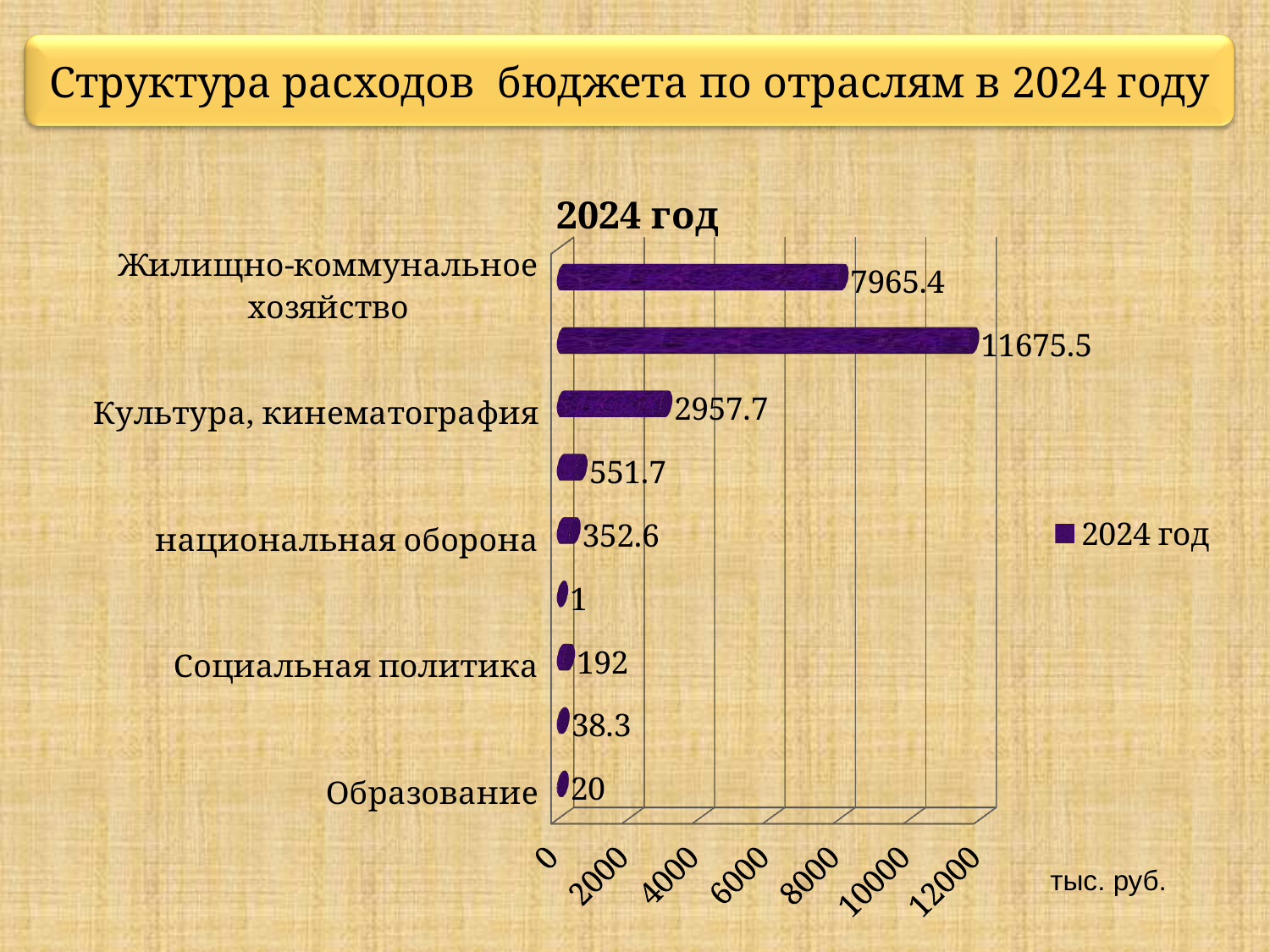
What kind of chart is shown on the slide? bar chart Is the value for Жилищно-коммунальное хозяйство greater or less than 6000? greater How many bars are plotted on the chart? 9 What is the value for Жилищно-коммунальное хозяйство? 7965.4 What is the difference between the values for Жилищно-коммунальное хозяйство and Культура, кинематография? 5007.7 What is the value for национальная оборона? 352.6 What is the value for Образование? 20 Which is larger, the value for Культура, кинематография or the value for национальная оборона? Культура, кинематография What is the largest value shown on the chart? 11675.5 Among the labeled categories, which has the lowest value? Образование What is the value for Социальная политика? 192 What is the value for Культура, кинематография? 2957.7